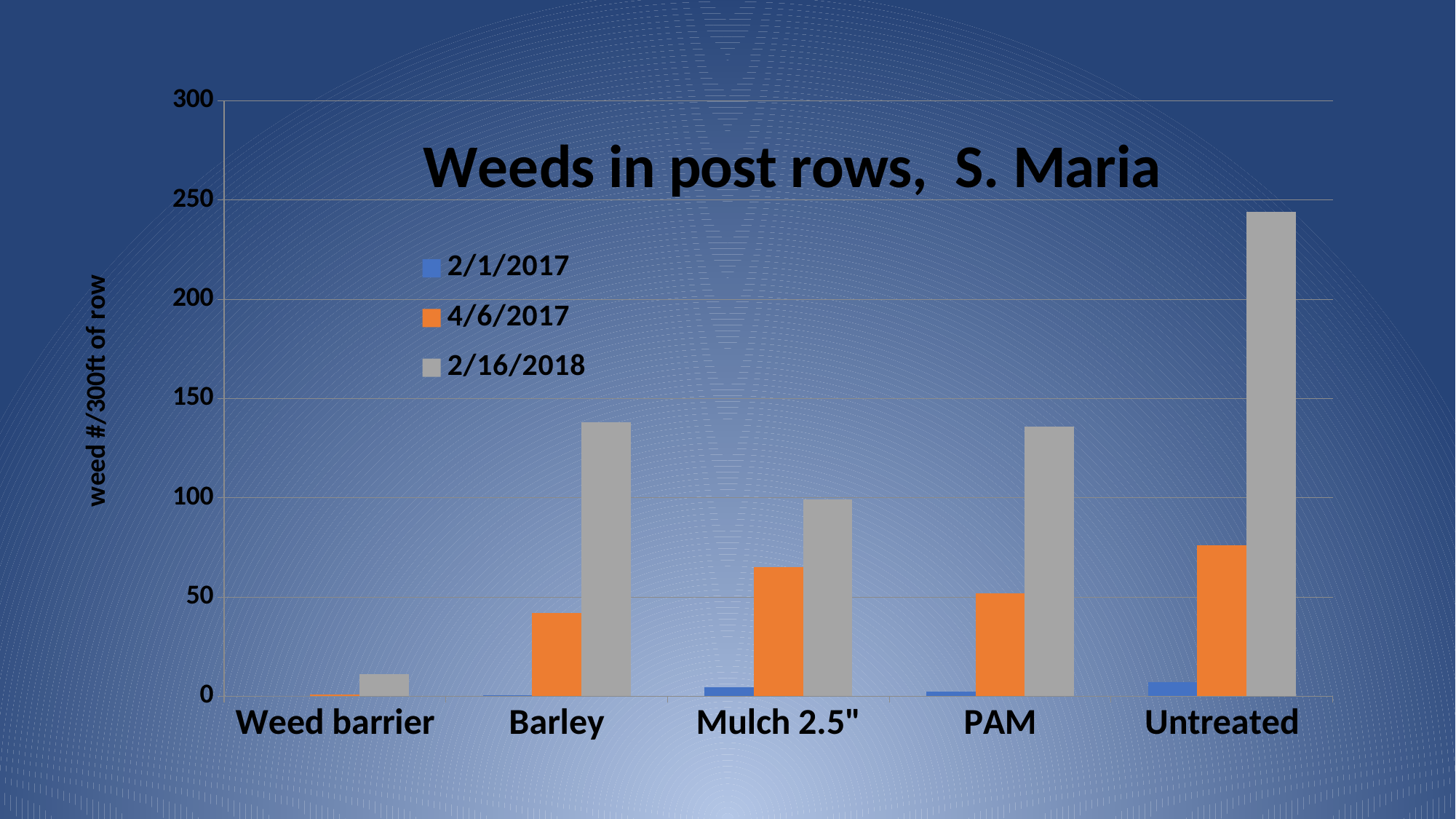
How many treatment categories are shown on the x axis? 5 For 2/16/2018, which is larger: Barley or Mulch 2.5"? Barley What kind of chart is shown on the slide? bar chart Is the value for Barley on 4/6/2017 greater or less than 50? less Which treatment has the lowest value for 2/16/2018? Weed barrier What is the title of the chart? Weeds in post rows, S. Maria How many series does the legend list? 3 Which treatment has the highest value for 4/6/2017? Untreated Is the value for Untreated on 2/16/2018 greater or less than 200? greater Which treatment has the highest value for 2/16/2018? Untreated Is the value for Mulch 2.5" on 4/6/2017 greater or less than 50? greater What is the label on the vertical axis? weed #/300ft of row